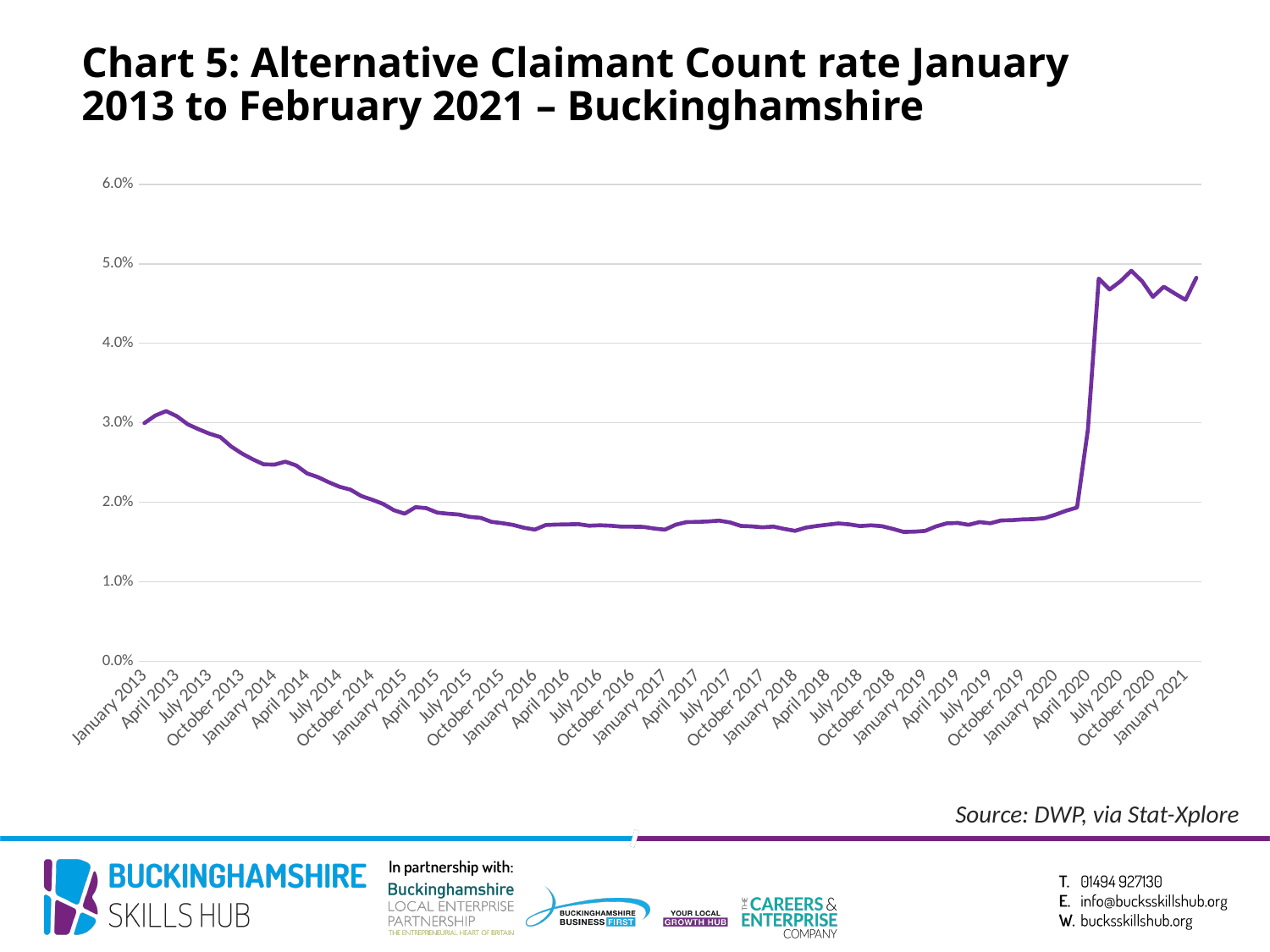
Is the value for July 2020 greater or less than 4.0%? greater Is the value for January 2013 greater or less than 2.0%? greater What kind of chart is shown on the slide? Line chart Is the value for January 2019 greater or less than 2.0%? less Does the claimant count rate rise or fall between January 2013 and January 2016? Fall What is the title of the chart? Chart 5: Alternative Claimant Count rate January 2013 to February 2021 – Buckinghamshire Which is larger, the value for January 2013 or the value for January 2019? January 2013 What source is cited for the chart? DWP, via Stat-Xplore How many data series are plotted on the chart? 1 Which is larger, the value for July 2020 or the value for January 2013? July 2020